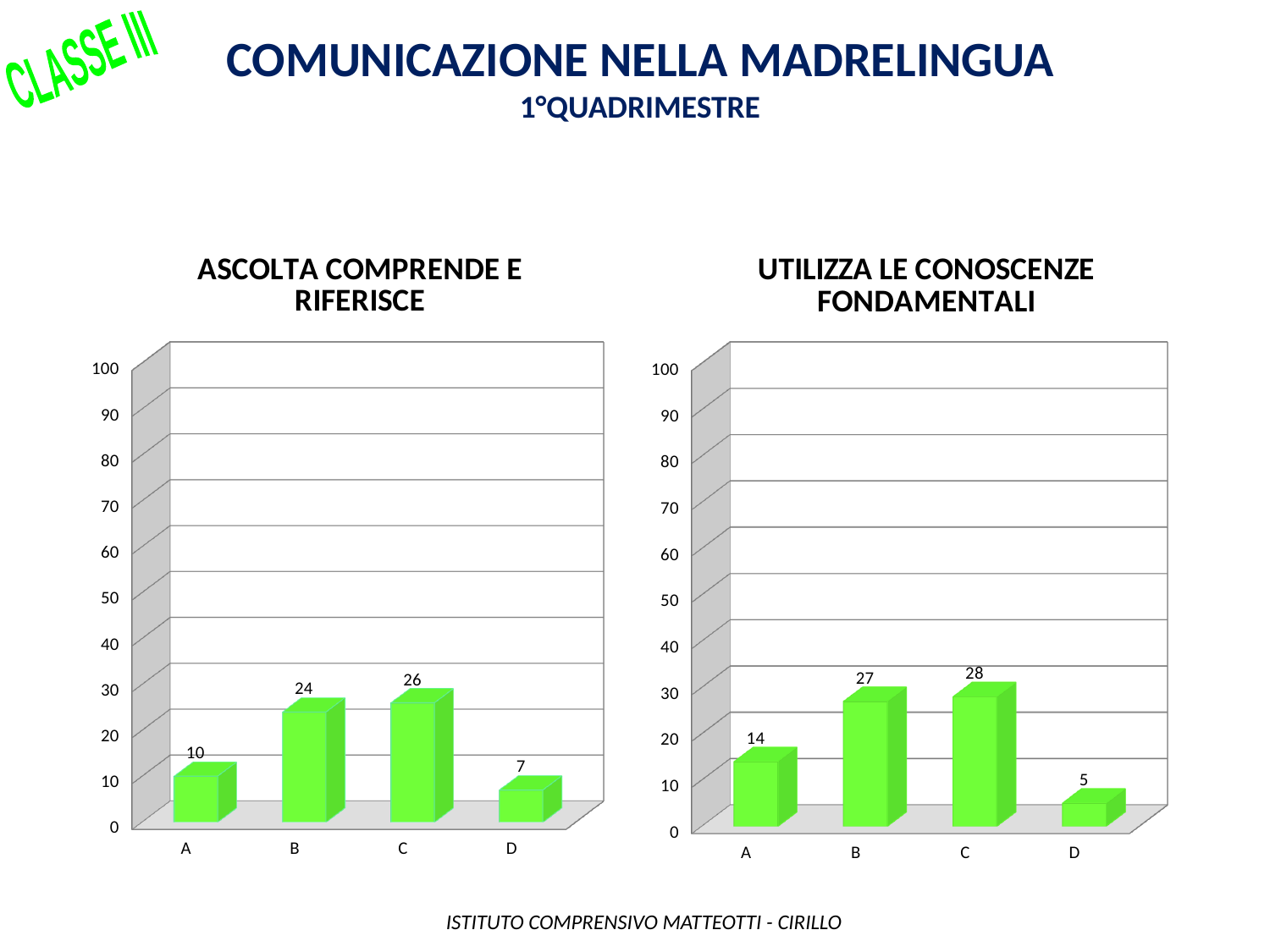
In the 'UTILIZZA LE CONOSCENZE FONDAMENTALI' chart, what is the difference between the values for B and D? 22 In the 'UTILIZZA LE CONOSCENZE FONDAMENTALI' chart, is the value for C greater or less than 20? greater In the 'ASCOLTA COMPRENDE E RIFERISCE' chart, which category has the highest value? C In the 'ASCOLTA COMPRENDE E RIFERISCE' chart, what is the value for category B? 24 In the 'UTILIZZA LE CONOSCENZE FONDAMENTALI' chart, what is the value for category A? 14 In the 'ASCOLTA COMPRENDE E RIFERISCE' chart, which category has the lowest value? D In the 'UTILIZZA LE CONOSCENZE FONDAMENTALI' chart, what is the value for category D? 5 In the 'ASCOLTA COMPRENDE E RIFERISCE' chart, how many categories are shown on the x axis? 4 In the 'UTILIZZA LE CONOSCENZE FONDAMENTALI' chart, which is larger, the value for A or the value for D? A What kind of chart is the 'ASCOLTA COMPRENDE E RIFERISCE' chart? Bar chart In the 'UTILIZZA LE CONOSCENZE FONDAMENTALI' chart, which category has the highest value? C In the 'ASCOLTA COMPRENDE E RIFERISCE' chart, what is the difference between the values for C and A? 16